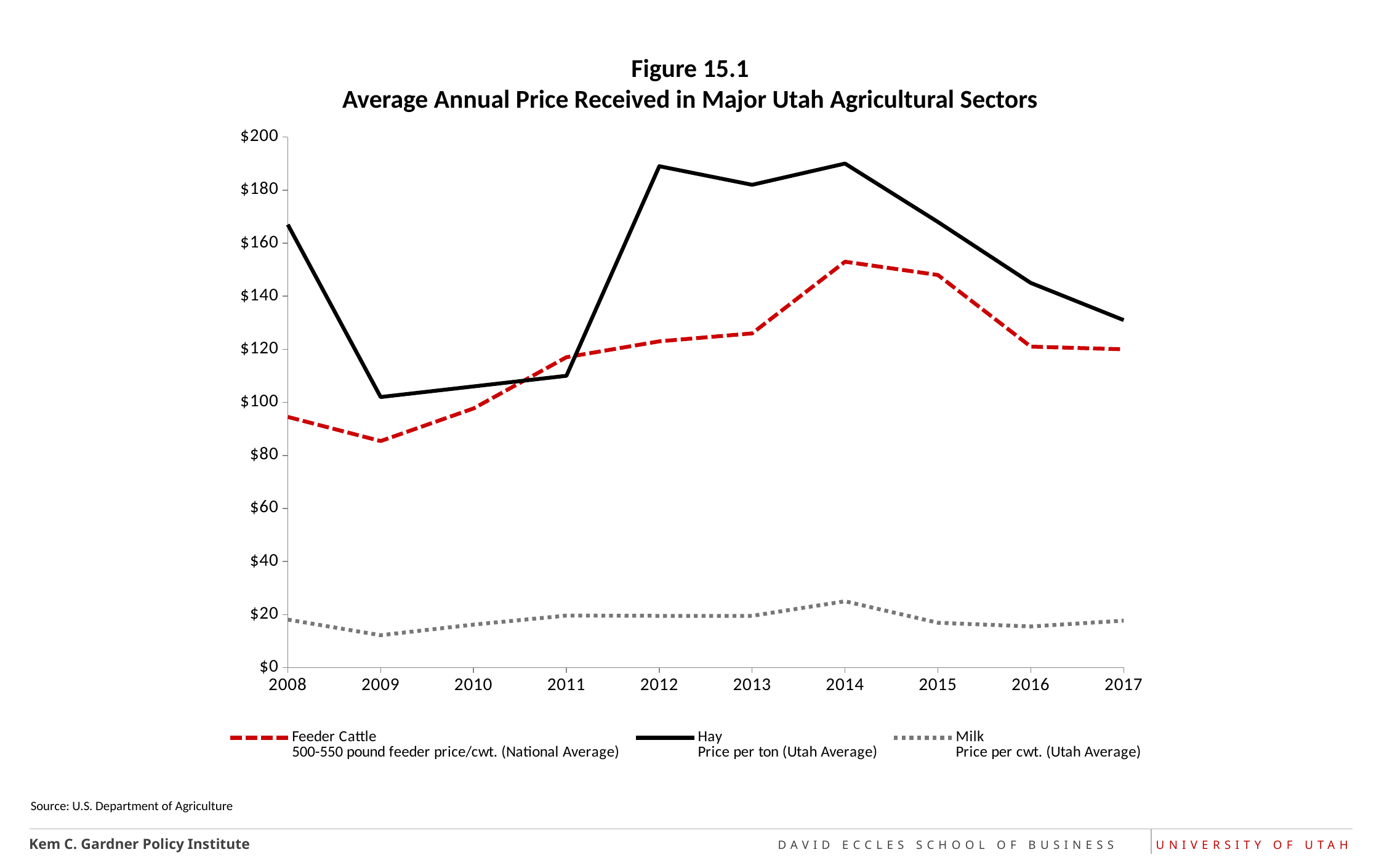
Does the Hay price rise or fall from 2014 to 2017? Fall According to the legend, what unit is the Hay price given in? Price per ton (Utah Average) Which is larger in 2017, the Hay price or the Feeder Cattle price? Hay Is the Milk value for 2014 greater or less than $40? less Is the Hay value for 2008 greater or less than $160? greater In which year is the Feeder Cattle price highest? 2014 In which year is the Hay price lowest? 2009 Is the Feeder Cattle value for 2009 greater or less than $100? less What kind of chart is shown in Figure 15.1? Line chart How many years are shown on the x axis? 10 In which year is the Milk price highest? 2014 How many series does the legend list? 3